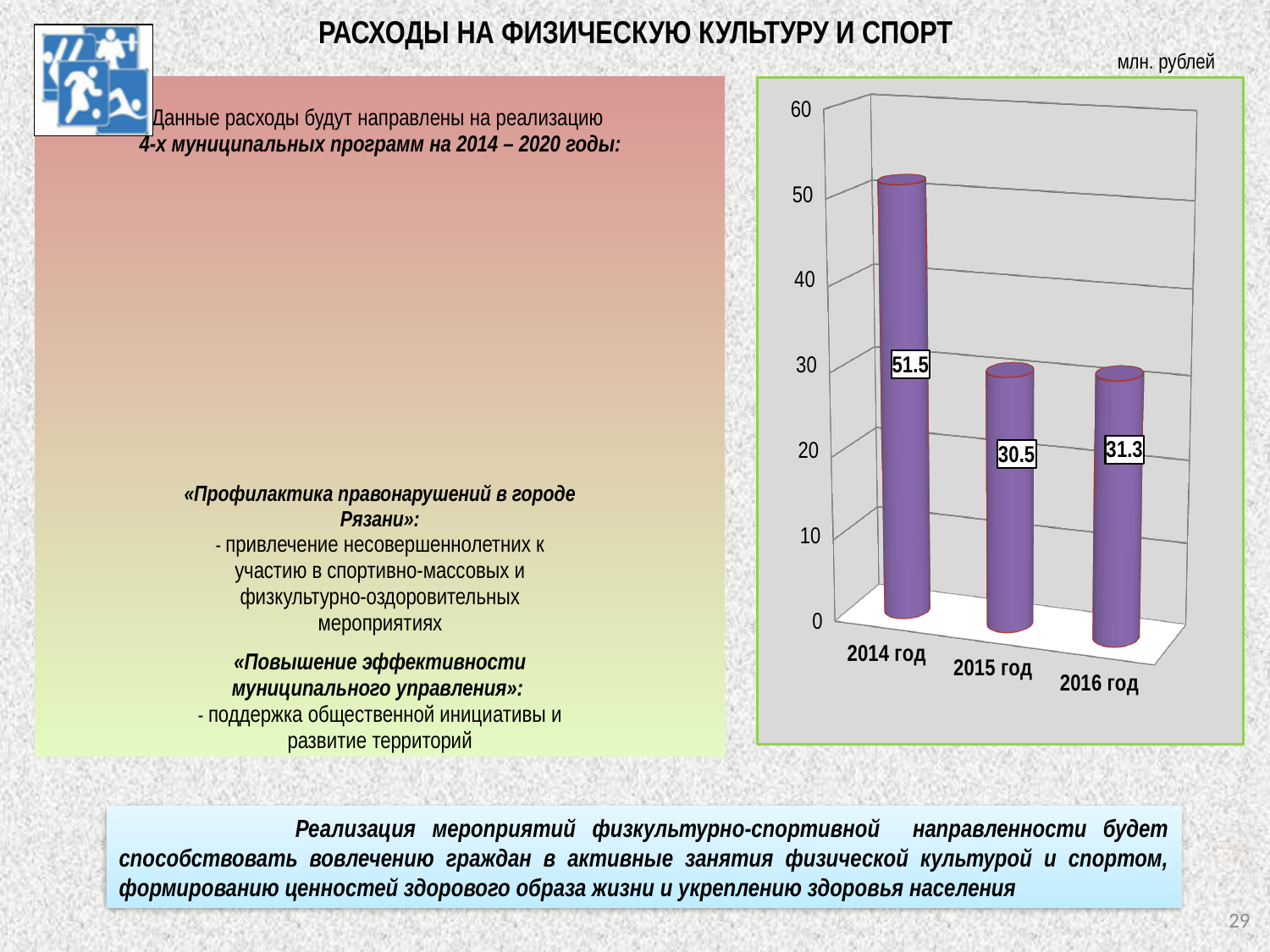
What is the value for 2014 год? 51.5 Is the value for 2014 год greater or less than 50? greater What kind of chart is shown on the slide? bar chart What is the value for 2015 год? 30.5 What is the difference between the values for 2014 год and 2015 год? 21.0 How many years are shown on the chart? 3 In what units are the chart values given? млн. рублей Which year has the highest value? 2014 год What is the value for 2016 год? 31.3 Which is larger, the value for 2014 год or the value for 2016 год? 2014 год What is the difference between the values for 2016 год and 2015 год? 0.8 Which year has the lowest value? 2015 год